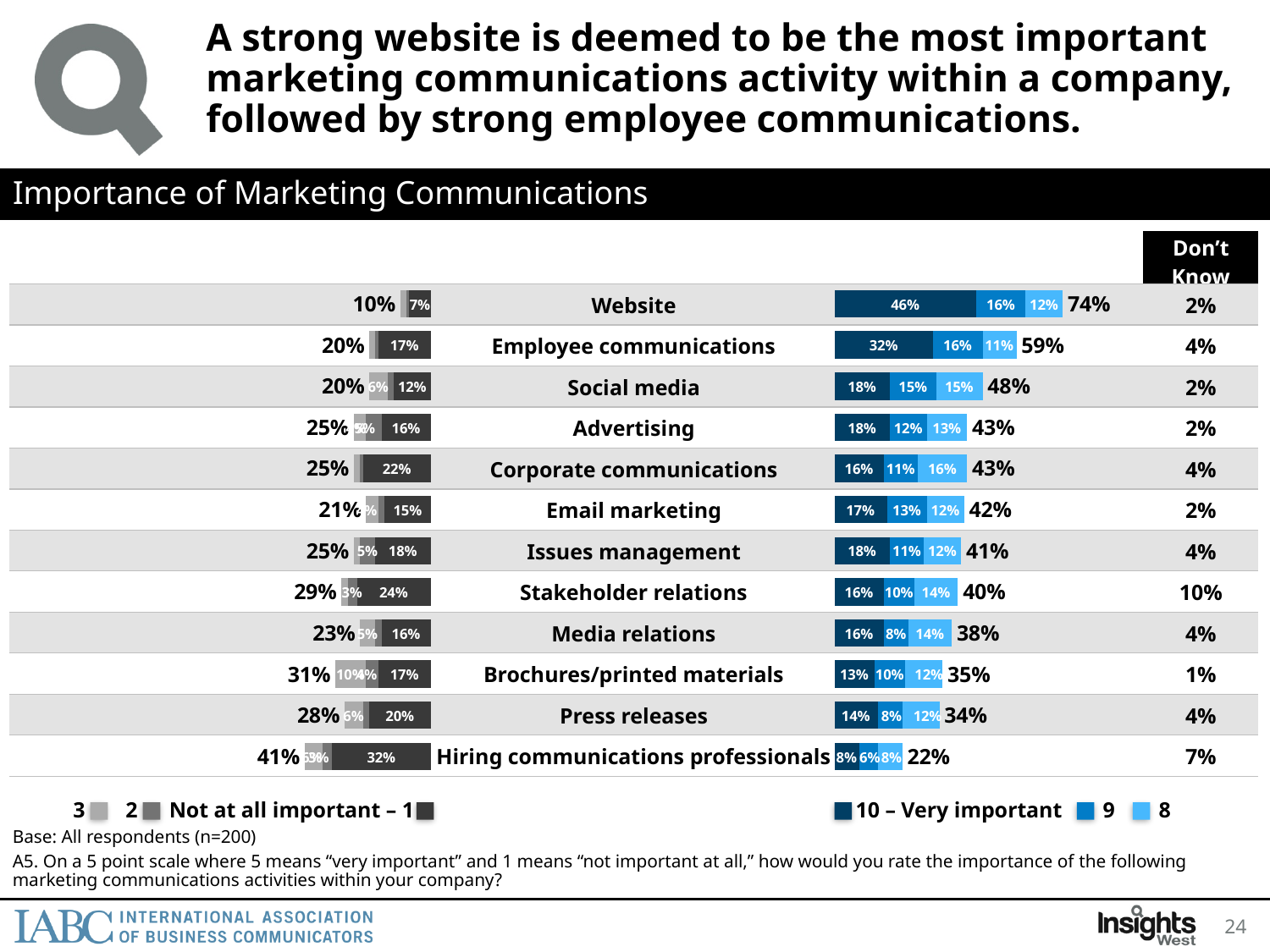
What percentage of respondents rated Hiring communications professionals as Not at all important – 1? 32% What is the combined top-three (8, 9, 10) percentage shown for Employee communications? 59% Which activity has the highest combined bottom-three (1, 2, 3) percentage? Hiring communications professionals What is the Don't Know percentage for Stakeholder relations? 10% What kind of chart is shown on the slide? Stacked bar chart How many marketing communications activities are listed in the chart? 12 What percentage of respondents rated Website as 10 – Very important? 46% Which activity has the lowest combined top-three (8, 9, 10) percentage? Hiring communications professionals Which activity has the highest combined top-three (8, 9, 10) percentage? Website How many series does the legend list? 6 What is the difference between the combined top-three percentage for Website and for Employee communications? 15% Which has a larger combined top-three percentage, Social media or Press releases? Social media